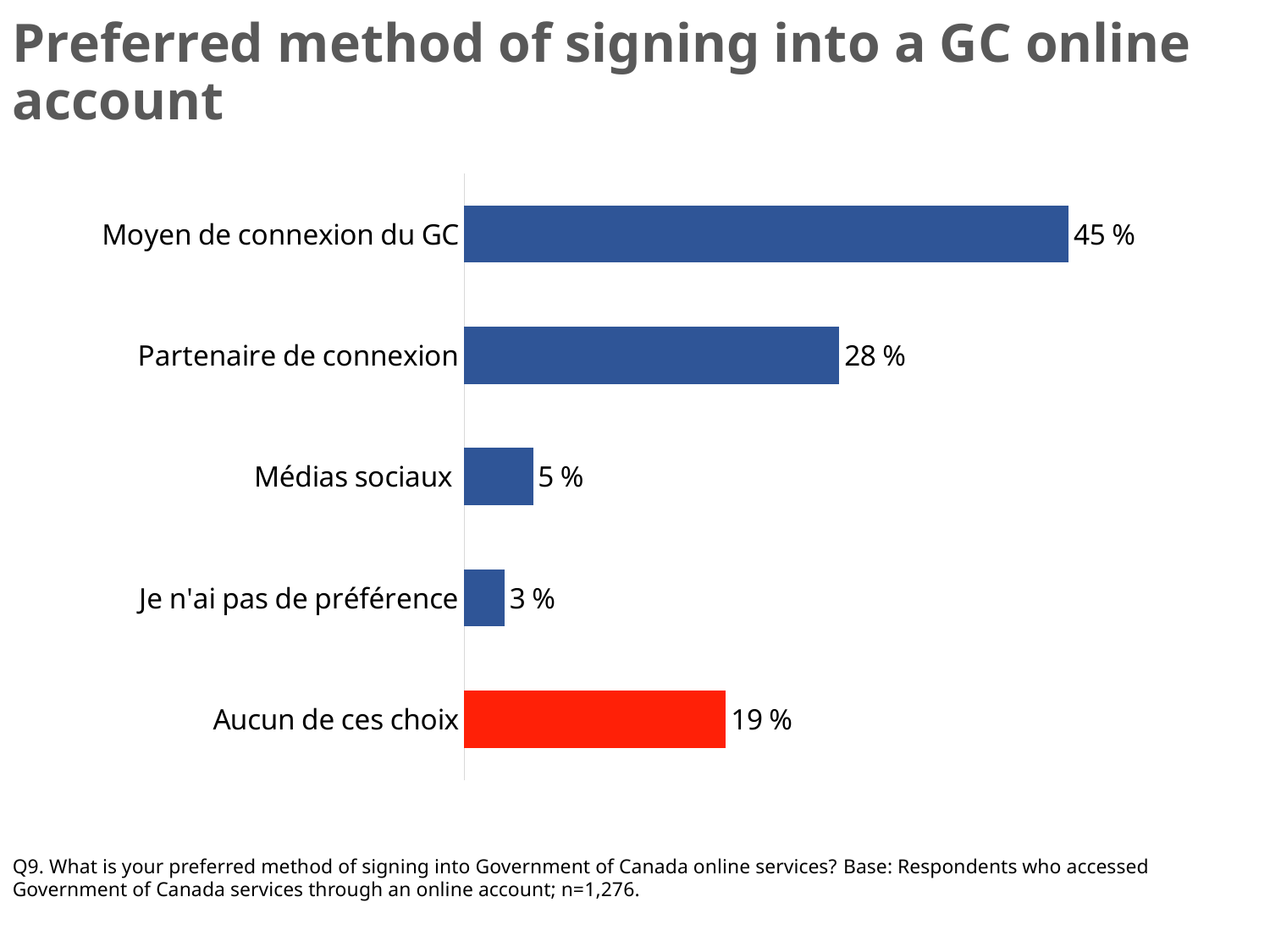
How many categories are shown in the chart? 5 What is the value for Partenaire de connexion? 28 % What is the difference between Aucun de ces choix and Médias sociaux? 14 % What is the value for Aucun de ces choix? 19 % Which is larger, Partenaire de connexion or Aucun de ces choix? Partenaire de connexion What is the difference between Moyen de connexion du GC and Partenaire de connexion? 17 % What is the value for Médias sociaux? 5 % What kind of chart is shown on the slide? Bar chart Which category has the highest value? Moyen de connexion du GC Which category's bar is coloured red? Aucun de ces choix What is the value for Moyen de connexion du GC? 45 % Which category has the lowest value? Je n'ai pas de préférence